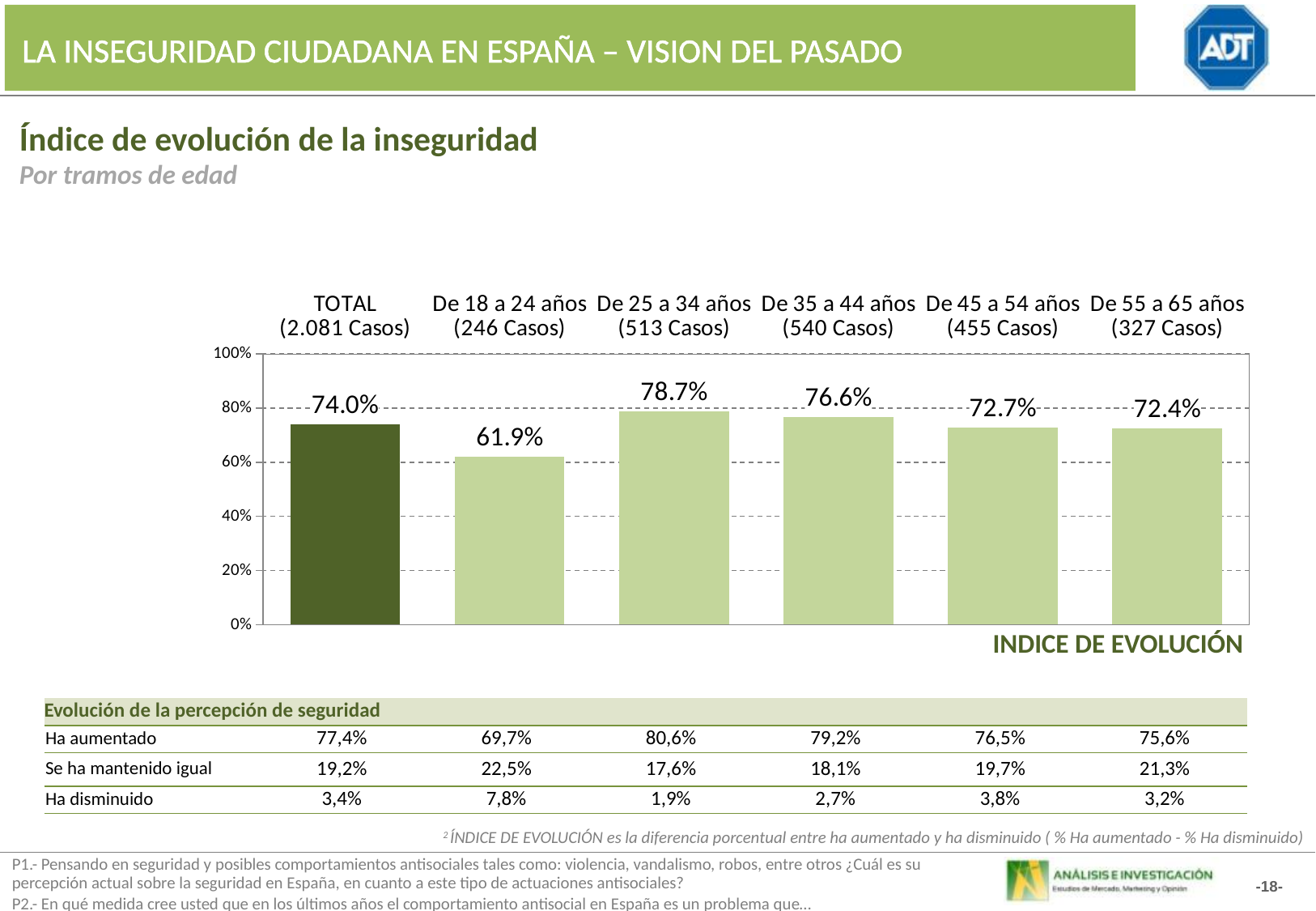
What is the value shown for De 25 a 34 años in the chart? 78.7% What kind of chart is shown on the slide? Bar chart What is the value shown for TOTAL in the chart? 74.0% What is the difference between the values for De 25 a 34 años and De 18 a 24 años? 16.8 percentage points Which is larger, the value for De 35 a 44 años or the value for De 45 a 54 años? De 35 a 44 años Which bar in the chart is drawn in a darker green than the others? TOTAL Which category has the lowest value in the chart? De 18 a 24 años What is the value shown for De 18 a 24 años in the chart? 61.9% Which age group has the highest value in the chart? De 25 a 34 años Is the value for De 55 a 65 años greater or less than 80%? less What is the value shown for De 45 a 54 años in the chart? 72.7% How many bars are plotted in the chart? 6